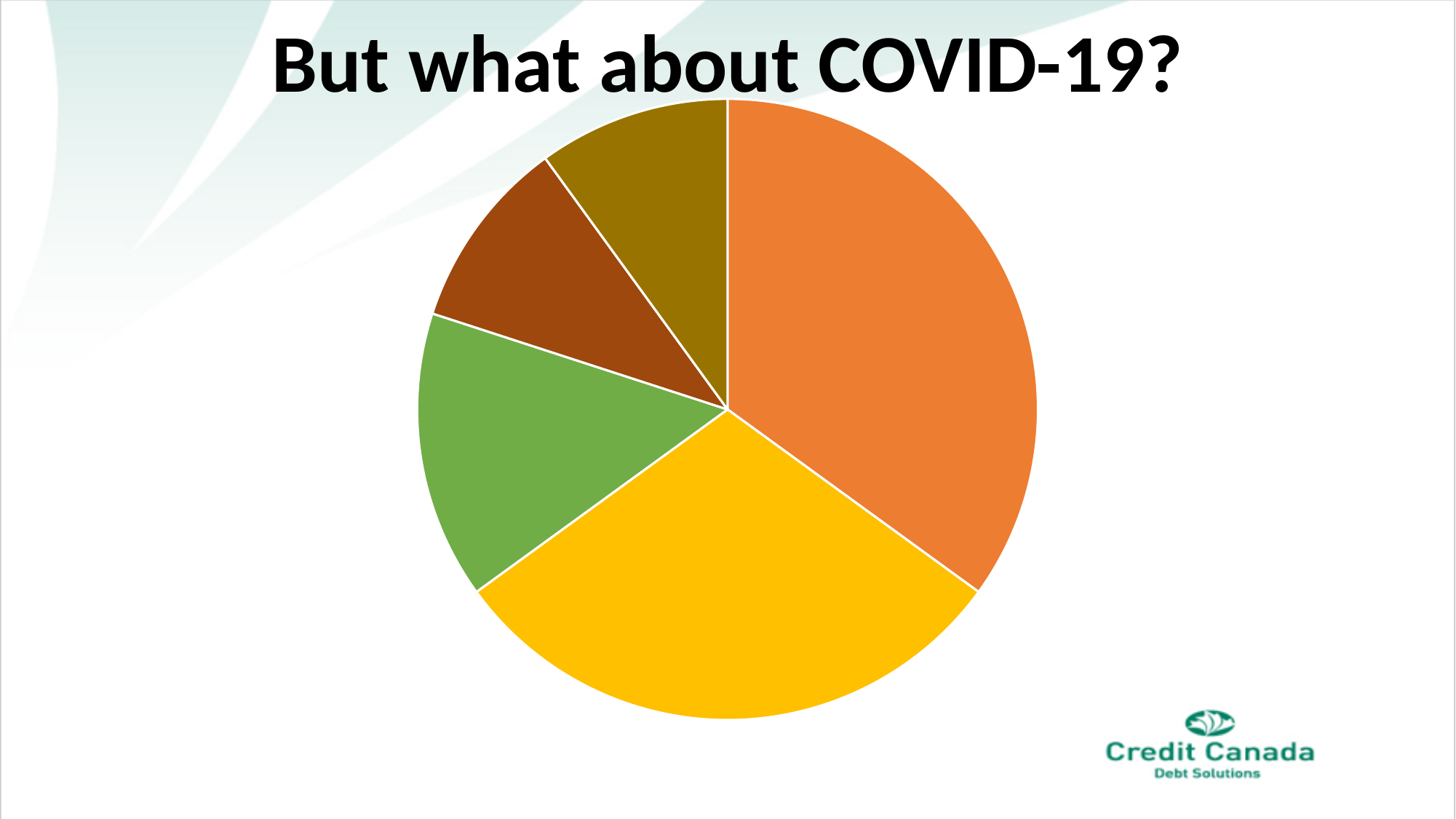
Which is larger in the pie chart, the orange slice or the yellow slice? the orange slice Which colour slice is the largest in the pie chart? orange Which is larger in the pie chart, the yellow slice or the green slice? the yellow slice Which is larger in the pie chart, the orange slice or the green slice? the orange slice Does the pie chart include a legend? No What kind of chart is shown on the slide? pie chart How many slices does the pie chart have? 5 What is the title shown above the pie chart? But what about COVID-19?